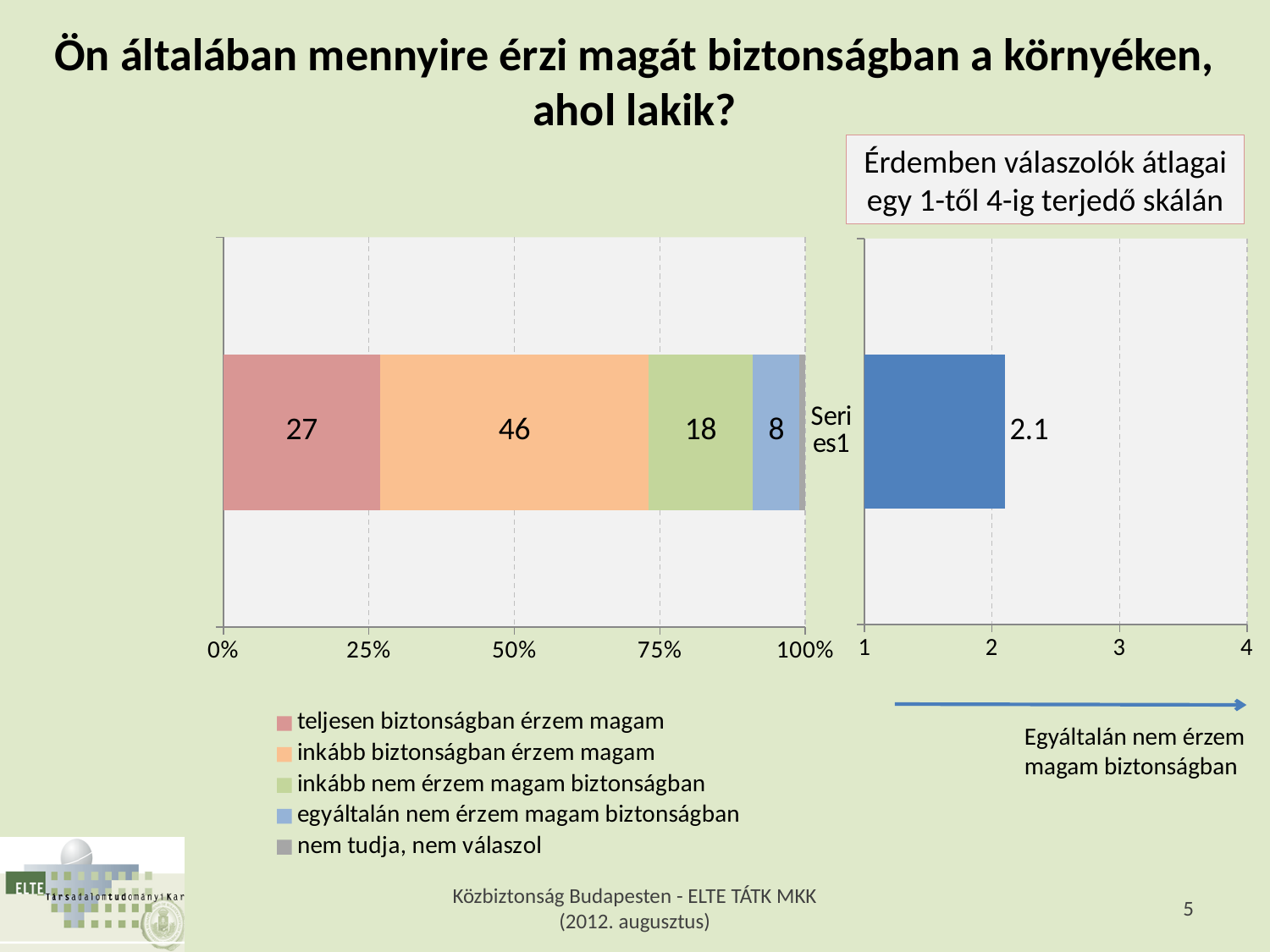
In the left stacked bar chart, what is the value for 'teljesen biztonságban érzem magam'? 27 In the left stacked bar chart, what is the value for 'inkább biztonságban érzem magam'? 46 In the left stacked bar chart, what is the value for 'egyáltalán nem érzem magam biztonságban'? 8 How many series does the legend of the left stacked bar chart list? 5 In the left stacked bar chart, what is the difference between the values for 'inkább biztonságban érzem magam' and 'teljesen biztonságban érzem magam'? 19 In the right chart, is the plotted value greater or less than 3? less In the left stacked bar chart, which is larger: the value for 'inkább nem érzem magam biztonságban' or for 'egyáltalán nem érzem magam biztonságban'? inkább nem érzem magam biztonságban In the left stacked bar chart, which legend category has the largest segment? inkább biztonságban érzem magam In the left stacked bar chart, what is the value for 'inkább nem érzem magam biztonságban'? 18 What is the highest tick value on the x axis of the right chart? 4 In the right chart ('Érdemben válaszolók átlagai egy 1-től 4-ig terjedő skálán'), what value is shown on the bar? 2.1 What kind of chart is the left chart on the slide? stacked bar chart